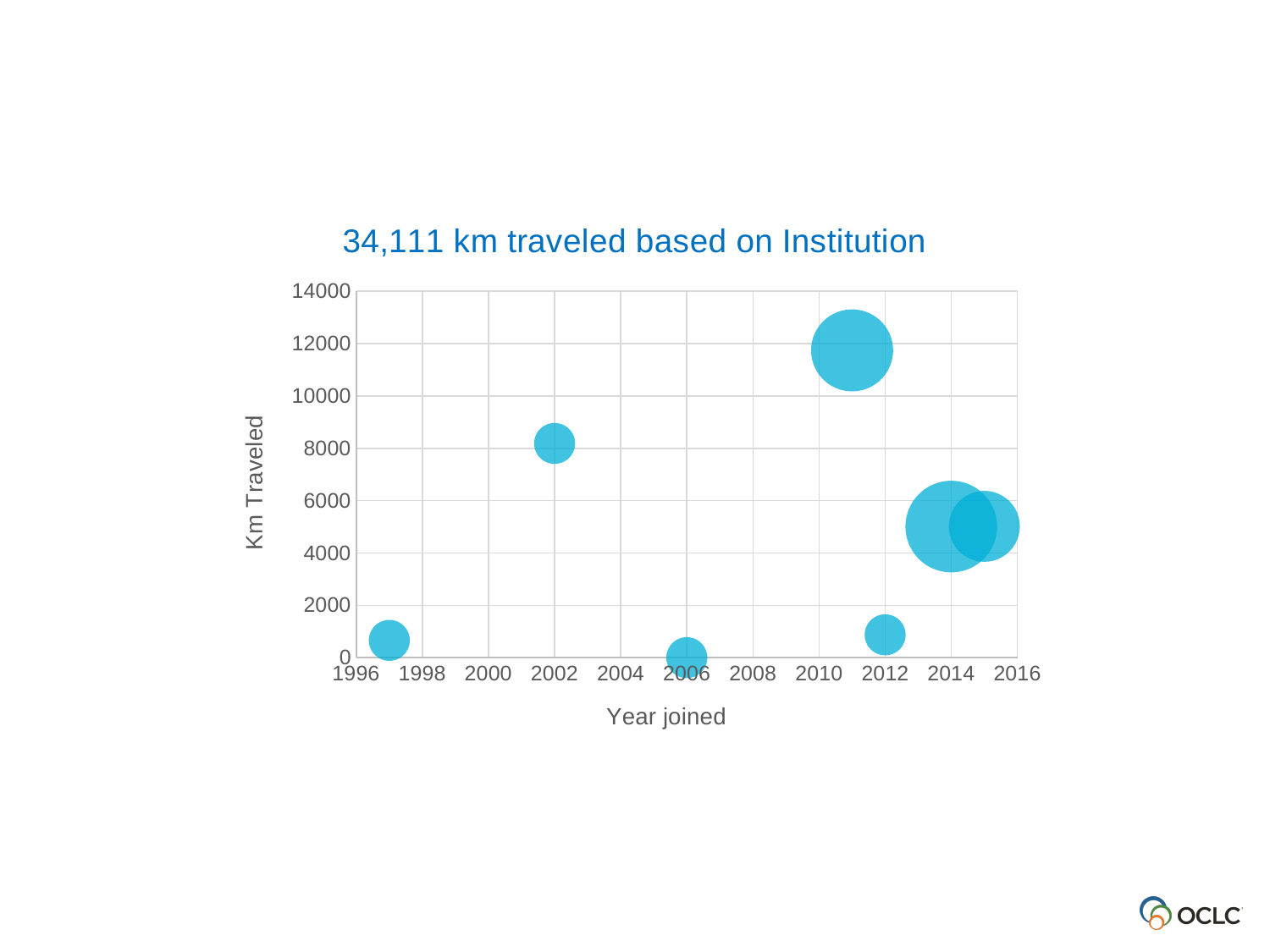
Is the Km Traveled value for the institution that joined in 2002 greater or less than 6000? greater Which has a higher Km Traveled value, the institution that joined in 2002 or the one that joined in 2012? 2002 What kind of chart is shown on the slide? bubble chart Which has a higher Km Traveled value, the institution that joined in 2011 or the one that joined in 2014? 2011 Which year joined has the lowest Km Traveled value? 2006 Is the Km Traveled value for the institution that joined in 1997 greater or less than 2000? less Is the Km Traveled value for the institution that joined in 2014 greater or less than 8000? less How many bubbles are plotted on the chart? 7 What is the label of the x axis? Year joined What is the title of the chart? 34,111 km traveled based on Institution Which year joined has the highest Km Traveled value? 2011